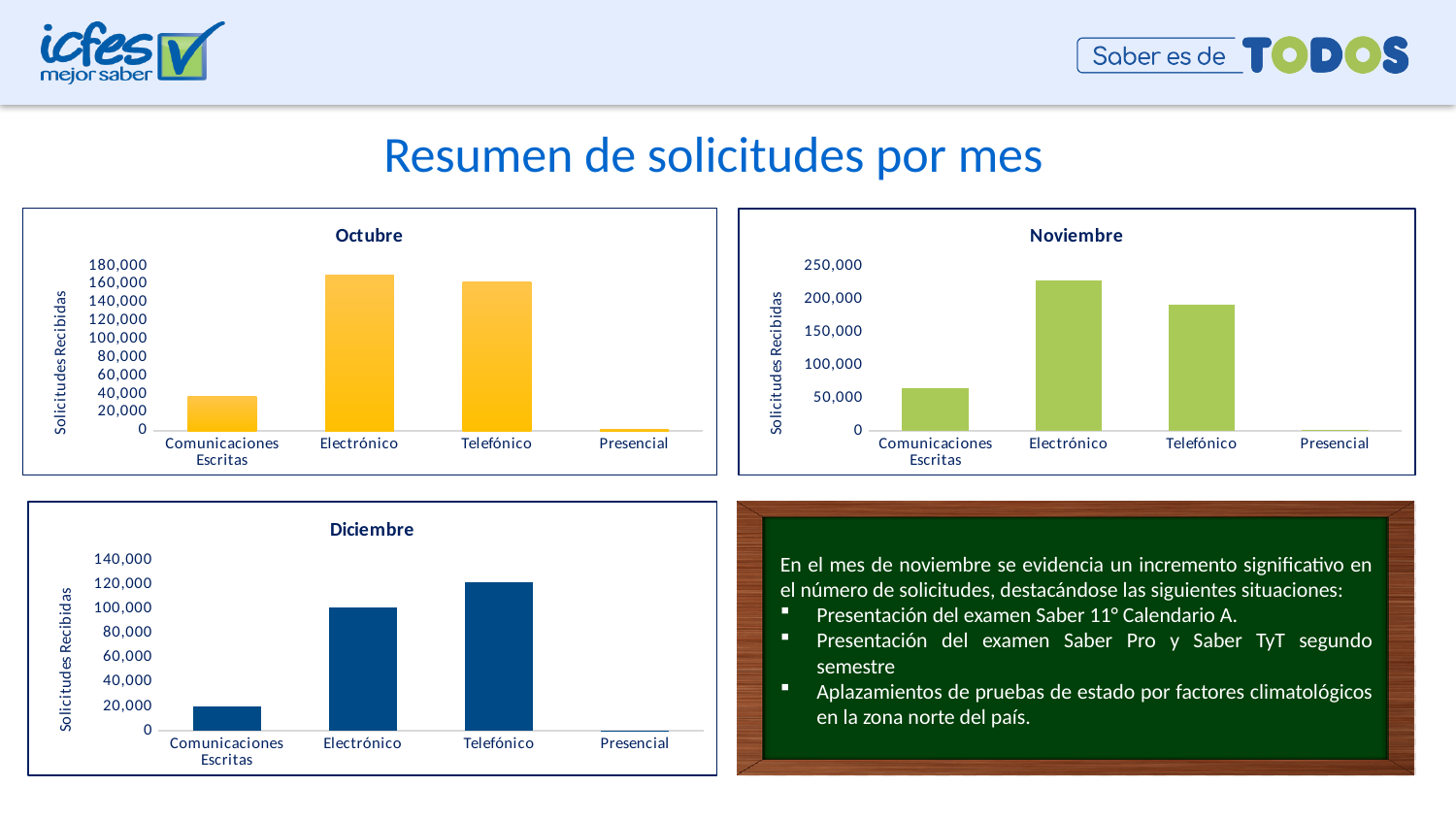
In the Octubre chart, is the value for Electrónico greater or less than 140,000? greater In the Noviembre chart, is the value for Telefónico greater or less than 150,000? greater In the Diciembre chart, which category has the highest value? Telefónico In the Diciembre chart, which is larger, Electrónico or Telefónico? Telefónico In the Diciembre chart, is the value for Comunicaciones Escritas greater or less than 40,000? less How many categories are shown on the x axis of the Diciembre chart? 4 In the Noviembre chart, which category has the highest value? Electrónico What kind of chart is the Noviembre chart? bar chart In the Octubre chart, which category has the highest value? Electrónico In the Octubre chart, which category has the lowest value? Presencial